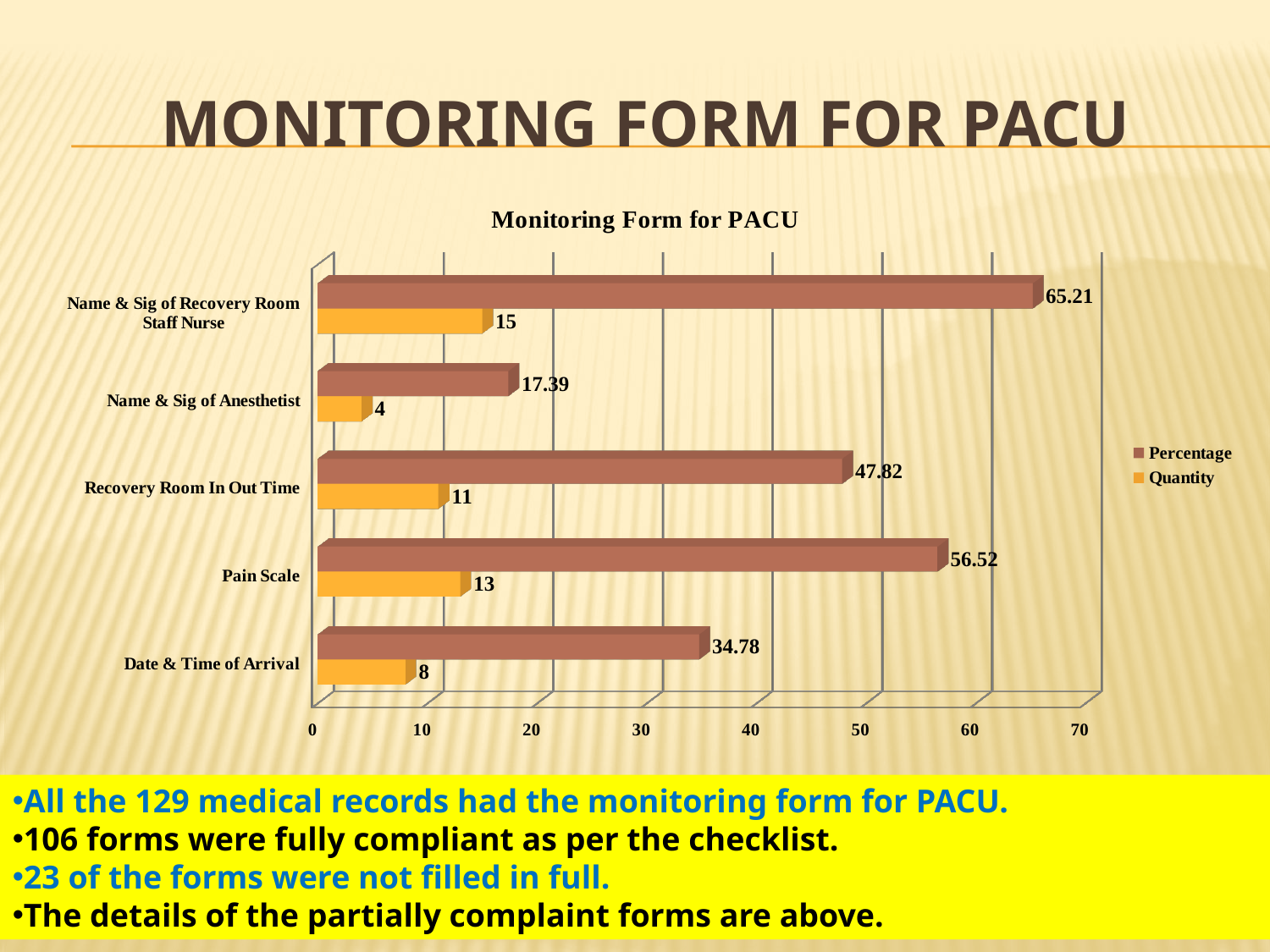
Which category has the highest Percentage value? Name & Sig of Recovery Room Staff Nurse What is the title of the chart? Monitoring Form for PACU Which has a larger Percentage value, Date & Time of Arrival or Recovery Room In Out Time? Recovery Room In Out Time What is the Quantity value for Name & Sig of Anesthetist? 4 What is the Percentage value for Pain Scale? 56.52 Which category has the lowest Quantity value? Name & Sig of Anesthetist What kind of chart is shown on the slide? Bar chart What is the difference between the Quantity values for Name & Sig of Recovery Room Staff Nurse and Date & Time of Arrival? 7 How many categories are shown on the chart? 5 What is the Quantity value for Recovery Room In Out Time? 11 How many series does the legend list? 2 What is the difference between the Percentage values for Pain Scale and Recovery Room In Out Time? 8.70